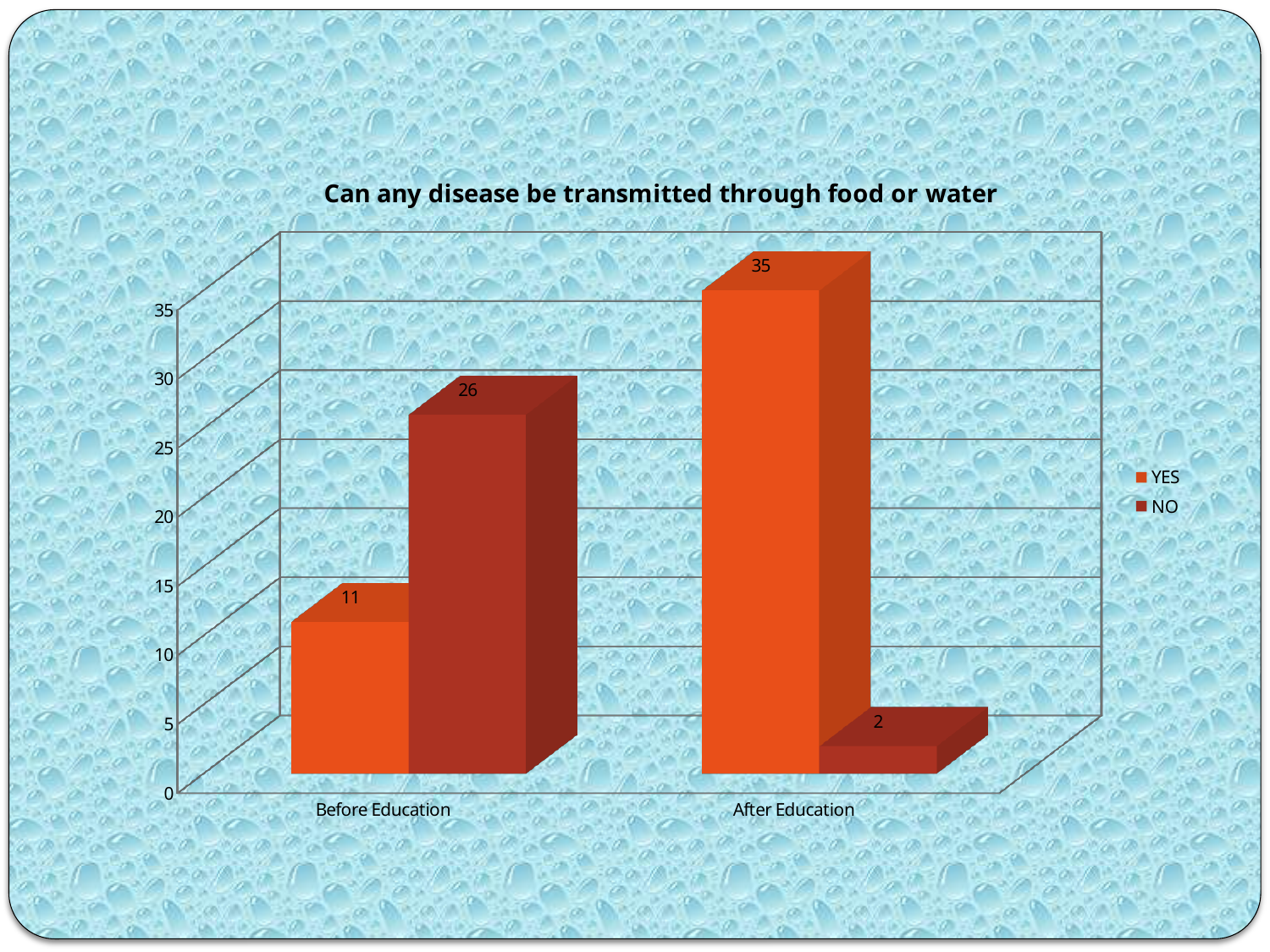
Which category has the highest YES value? After Education What is the difference between the NO and YES values in the Before Education category? 15 What is the value for NO in the After Education category? 2 What is the value for YES in the After Education category? 35 How many categories are shown on the x axis? 2 Which category has the lowest NO value? After Education What is the difference between the YES values for After Education and Before Education? 24 How many series does the legend list? 2 What is the value for NO in the Before Education category? 26 What is the value for YES in the Before Education category? 11 In the Before Education category, which is larger, YES or NO? NO What kind of chart is shown on the slide? Bar chart